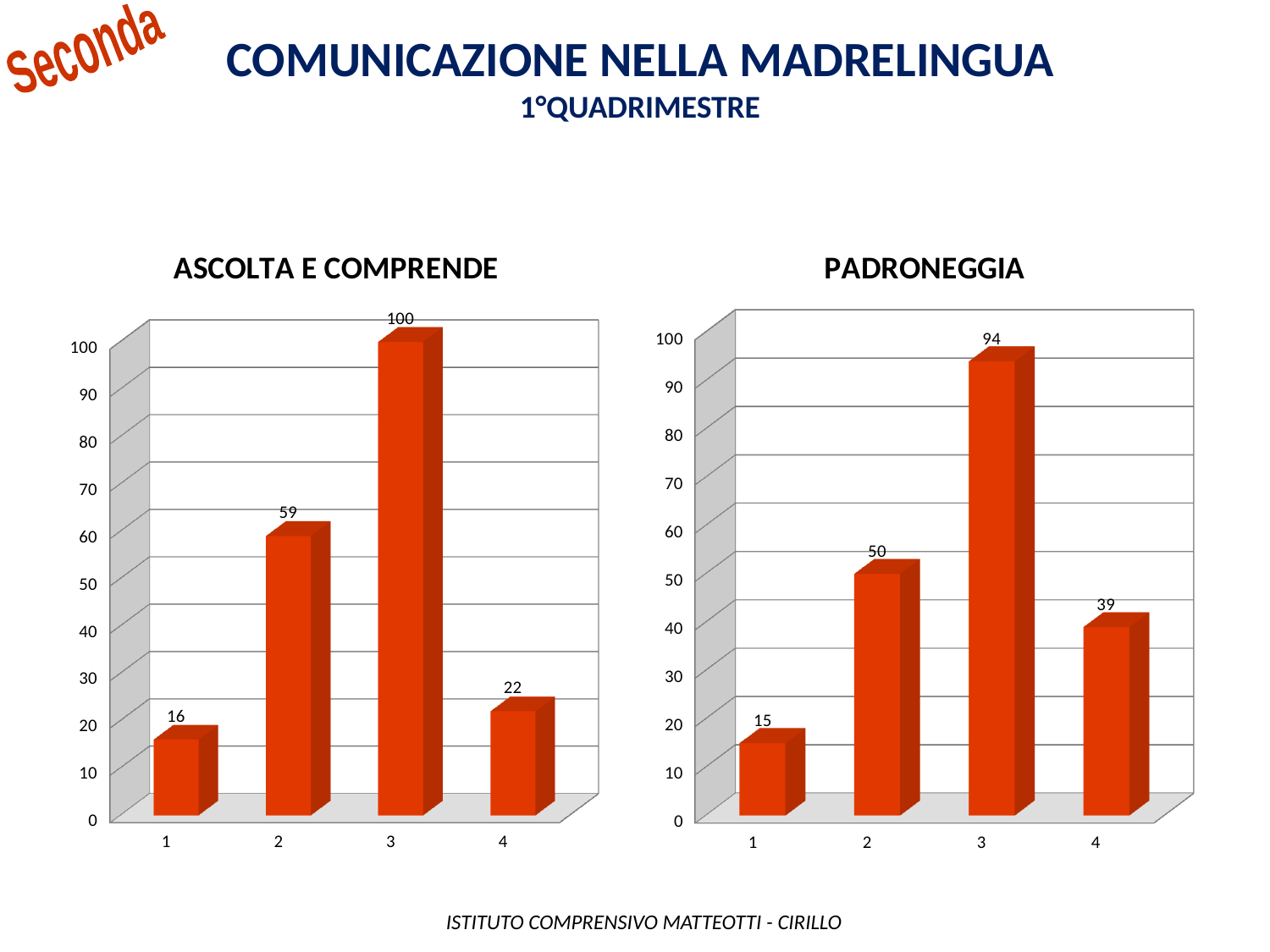
In the 'PADRONEGGIA' chart, which is larger: the value for category 4 or the value for category 1? category 4 In the 'PADRONEGGIA' chart, what is the value for category 2? 50 What is the title of the chart on the left side of the slide? ASCOLTA E COMPRENDE In the 'PADRONEGGIA' chart, what is the value for category 4? 39 In the 'ASCOLTA E COMPRENDE' chart, is the value for category 2 greater or less than 50? greater In the 'PADRONEGGIA' chart, which category has the highest value? 3 In the 'PADRONEGGIA' chart, what is the difference between the values for category 3 and category 1? 79 How many categories are shown in the 'PADRONEGGIA' chart? 4 In the 'ASCOLTA E COMPRENDE' chart, which category has the lowest value? 1 What kind of chart is the 'ASCOLTA E COMPRENDE' chart? bar chart In the 'ASCOLTA E COMPRENDE' chart, what is the difference between the values for category 2 and category 4? 37 In the 'ASCOLTA E COMPRENDE' chart, what is the value for category 3? 100